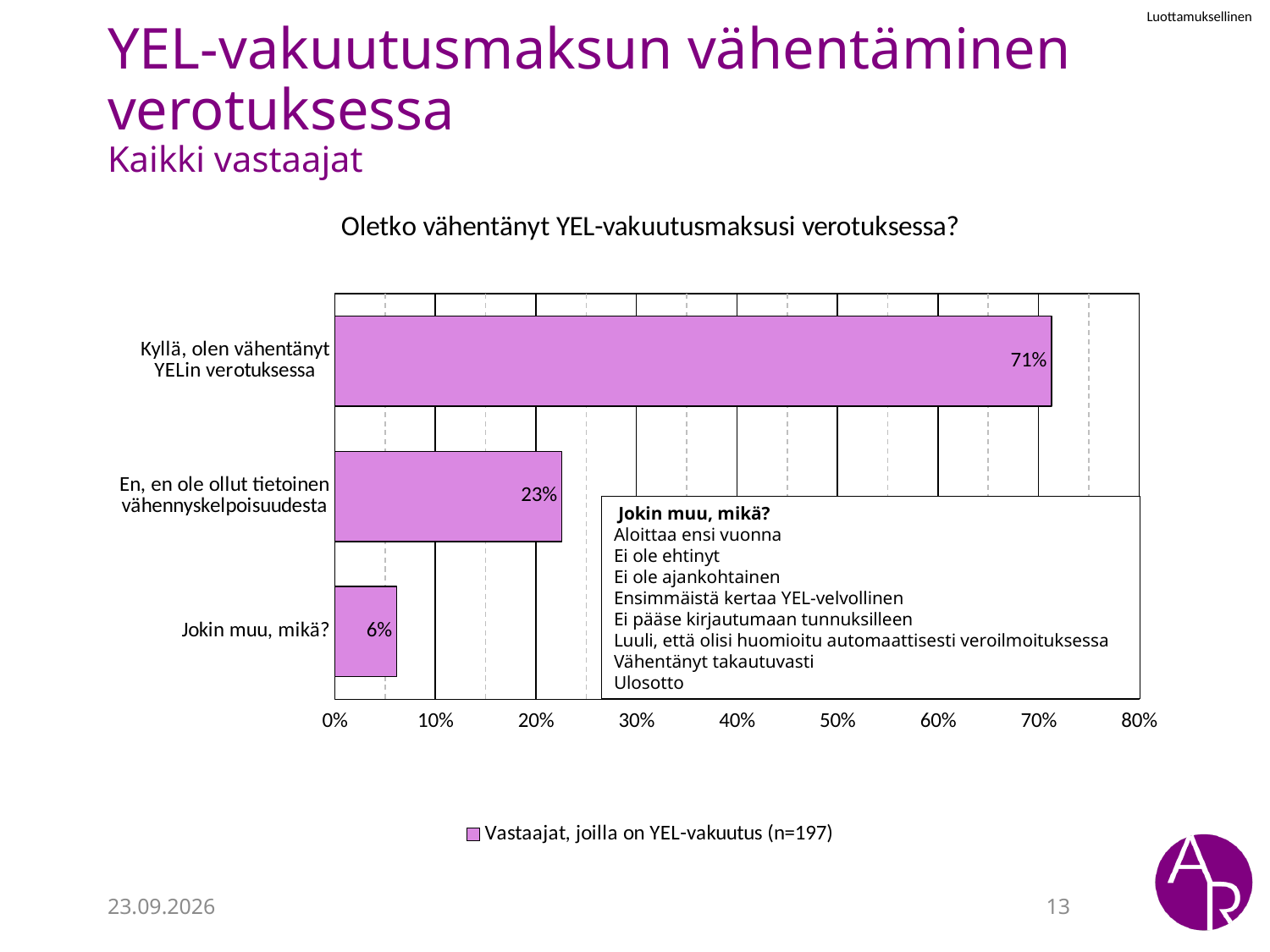
What is the difference between the values for "Kyllä, olen vähentänyt YELin verotuksessa" and "En, en ole ollut tietoinen vähennyskelpoisuudesta"? 48% How many categories are shown in the chart? 3 Which is larger, the value for "En, en ole ollut tietoinen vähennyskelpoisuudesta" or the value for "Jokin muu, mikä?"? En, en ole ollut tietoinen vähennyskelpoisuudesta Which category has the lowest value? Jokin muu, mikä? Which category has the highest value? Kyllä, olen vähentänyt YELin verotuksessa What kind of chart is shown on the slide? Bar chart What is the difference between the values for "En, en ole ollut tietoinen vähennyskelpoisuudesta" and "Jokin muu, mikä?"? 17% What series does the legend list? Vastaajat, joilla on YEL-vakuutus (n=197) What is the value for "En, en ole ollut tietoinen vähennyskelpoisuudesta"? 23% What is the value for "Jokin muu, mikä?"? 6% What is the value for "Kyllä, olen vähentänyt YELin verotuksessa"? 71% Is the value for "Kyllä, olen vähentänyt YELin verotuksessa" greater or less than 60%? greater